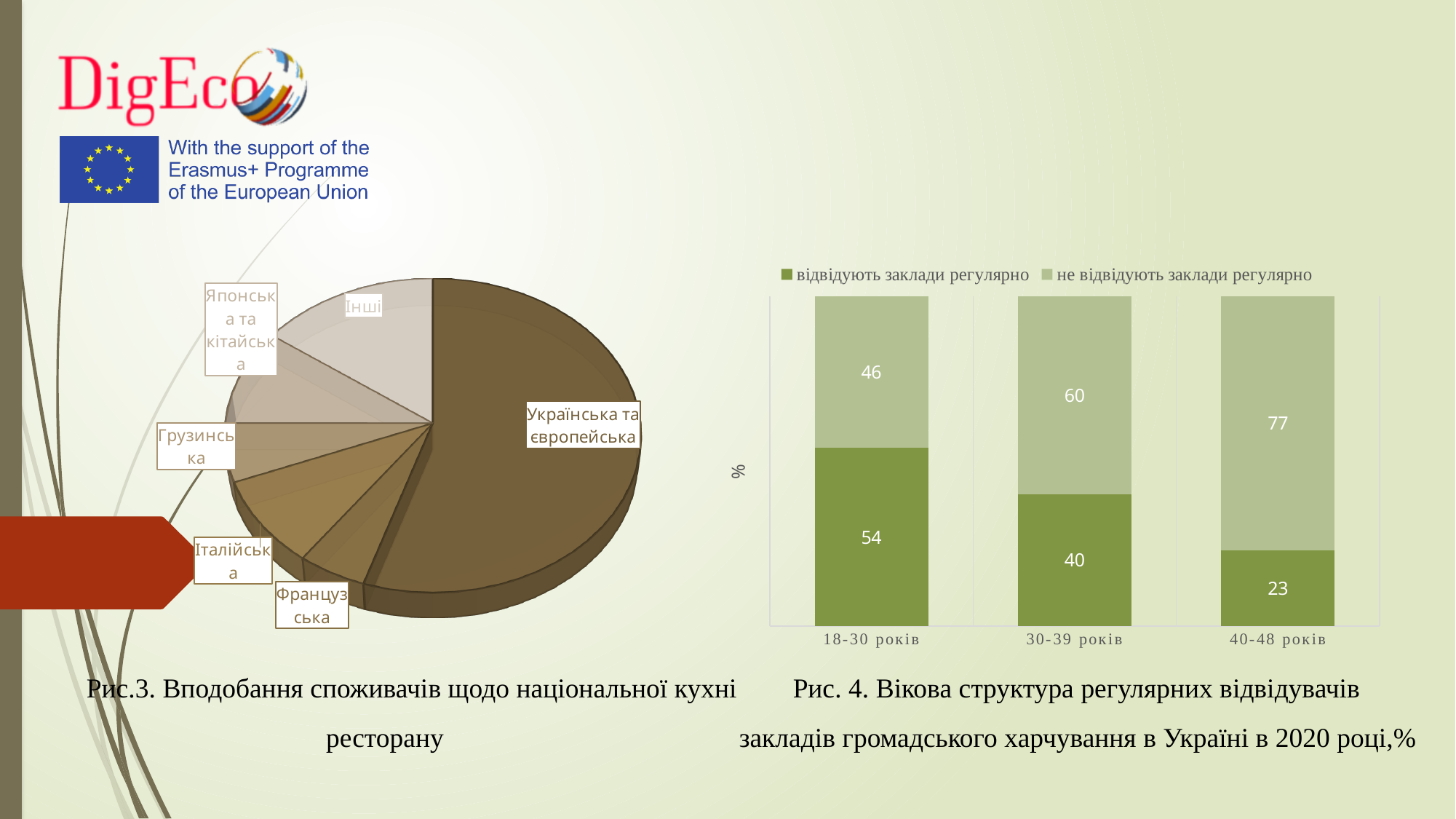
In the bar chart on the right (Рис. 4), which age group has the highest value for 'відвідують заклади регулярно'? 18-30 років In the pie chart on the left (Рис.3), which category has the largest slice? Українська та європейська In the bar chart on the right (Рис. 4), which age group has the lowest value for 'відвідують заклади регулярно'? 40-48 років In the bar chart on the right (Рис. 4), what is the value for 'не відвідують заклади регулярно' in the 30-39 років group? 60 How many series does the legend of the bar chart on the right (Рис. 4) list? 2 In the bar chart on the right (Рис. 4), which is larger for the 30-39 років group: 'відвідують заклади регулярно' or 'не відвідують заклади регулярно'? не відвідують заклади регулярно In the bar chart on the right (Рис. 4), what is the total of the stacked bar for 30-39 років? 100 What kind of chart is the chart on the left (Рис.3)? Pie chart In the bar chart on the right (Рис. 4), how does the value for 'відвідують заклади регулярно' change as the age groups go from 18-30 років to 40-48 років? It falls In the bar chart on the right (Рис. 4), what is the value for 'відвідують заклади регулярно' in the 18-30 років group? 54 In the bar chart on the right (Рис. 4), what is the difference between the 'відвідують заклади регулярно' values for 18-30 років and 40-48 років? 31 In the bar chart on the right (Рис. 4), what is the value for 'не відвідують заклади регулярно' in the 40-48 років group? 77